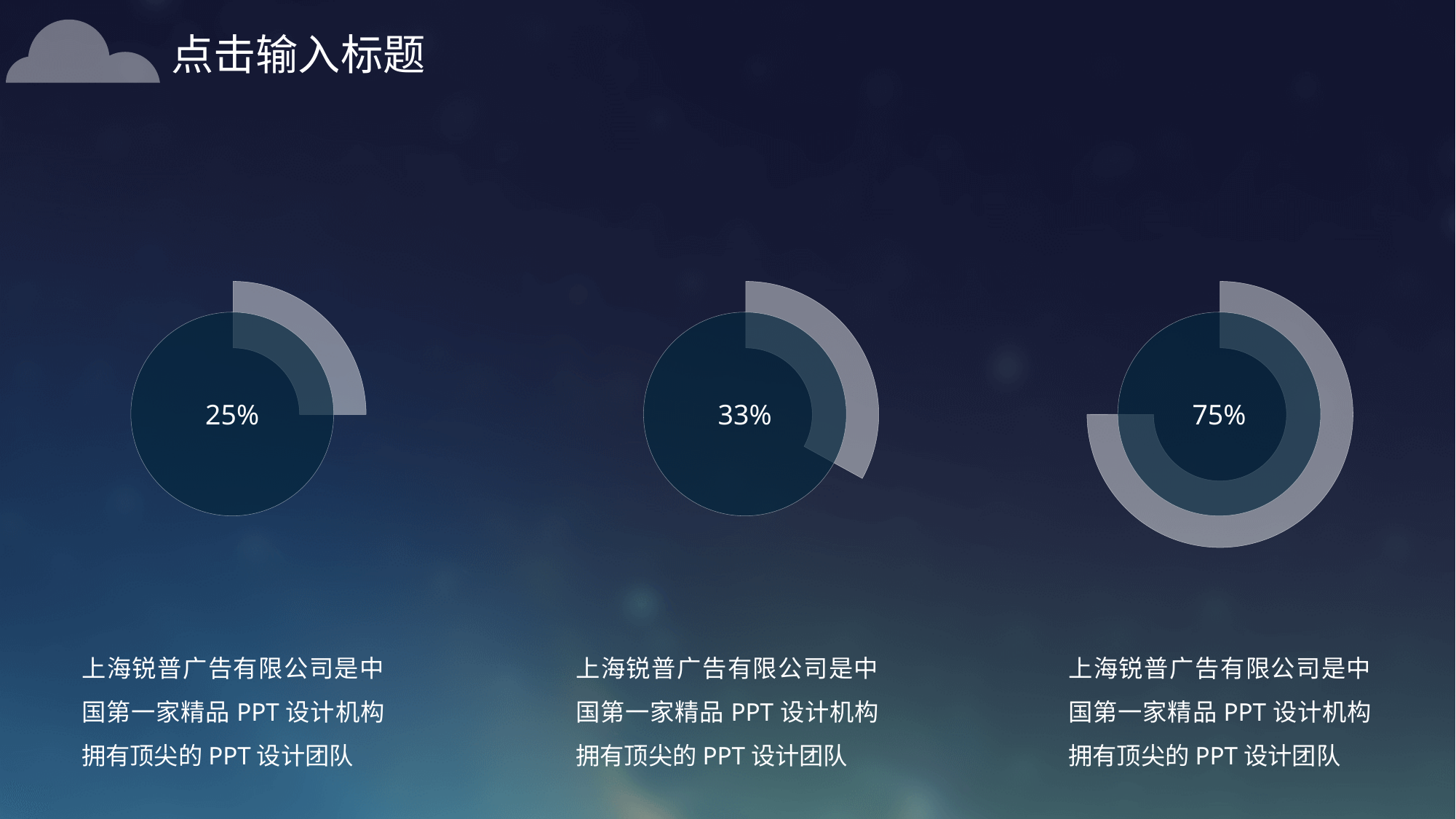
What is the title of the slide? 点击输入标题 What kind of chart is used to show the percentages on the slide? circular progress (donut) chart Which of the three charts shows the highest value? the right chart Which of the three charts shows the lowest value? the left chart What value is shown in the left chart? 25% What is the difference between the value in the right chart and the value in the left chart? 50% What value is shown in the middle chart? 33% What value is shown in the right chart? 75% Which is larger, the value in the middle chart or the value in the right chart? the right chart What is the difference between the value in the middle chart and the value in the left chart? 8% Do the values increase or decrease from the left chart to the right chart? increase How many circular charts are on the slide? 3